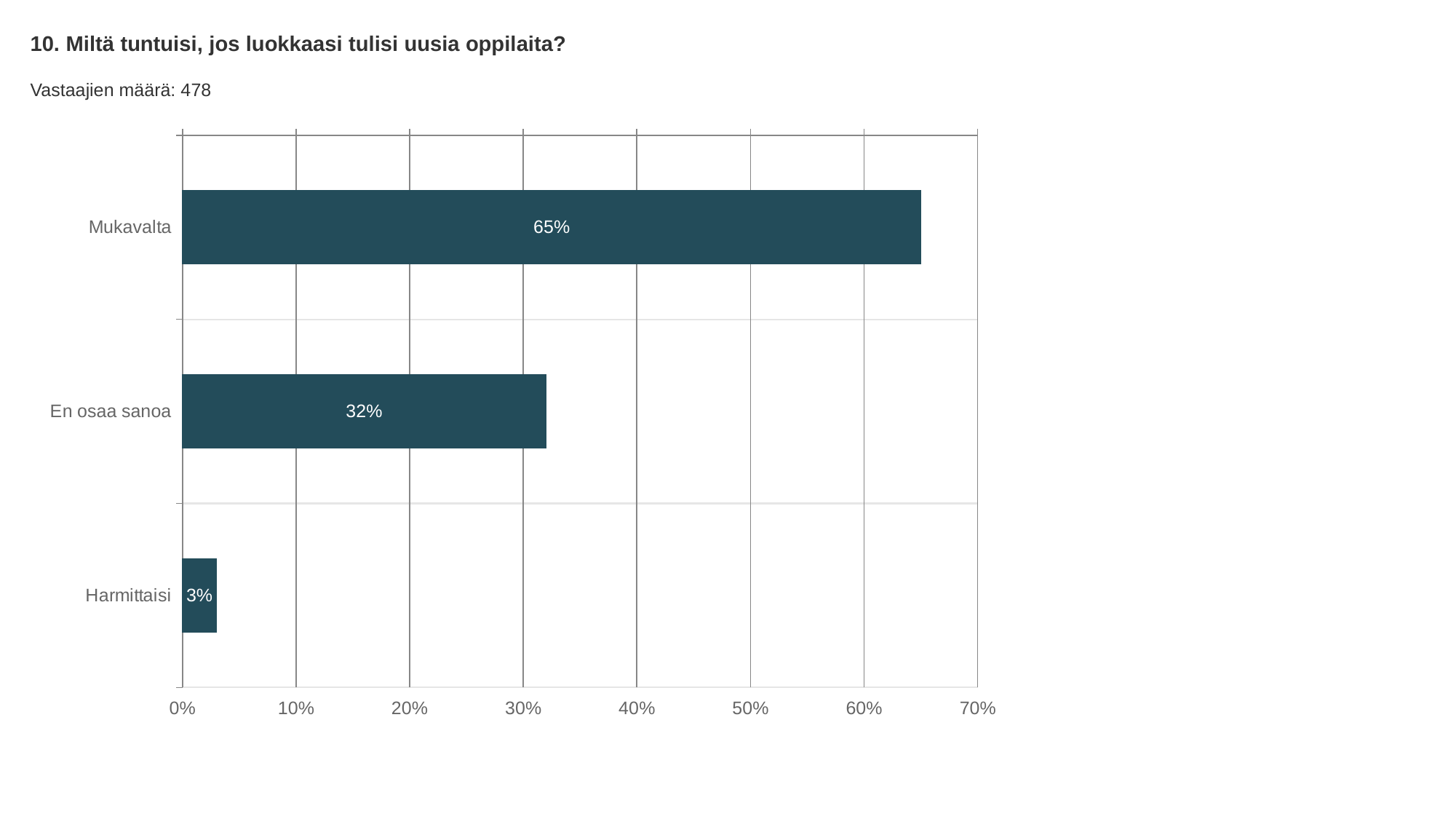
Which category has the lowest value? Harmittaisi Is the value for Mukavalta greater or less than 60%? greater What is the difference between the values for En osaa sanoa and Harmittaisi? 29% What kind of chart is shown on the slide? bar chart What is the value for Mukavalta? 65% Which category has the highest value? Mukavalta How many respondents (Vastaajien määrä) are reported on the slide? 478 What is the value for Harmittaisi? 3% How many categories are shown in the chart? 3 What is the difference between the values for Mukavalta and En osaa sanoa? 33% What is the value for En osaa sanoa? 32% Which is larger, the value for En osaa sanoa or the value for Harmittaisi? En osaa sanoa